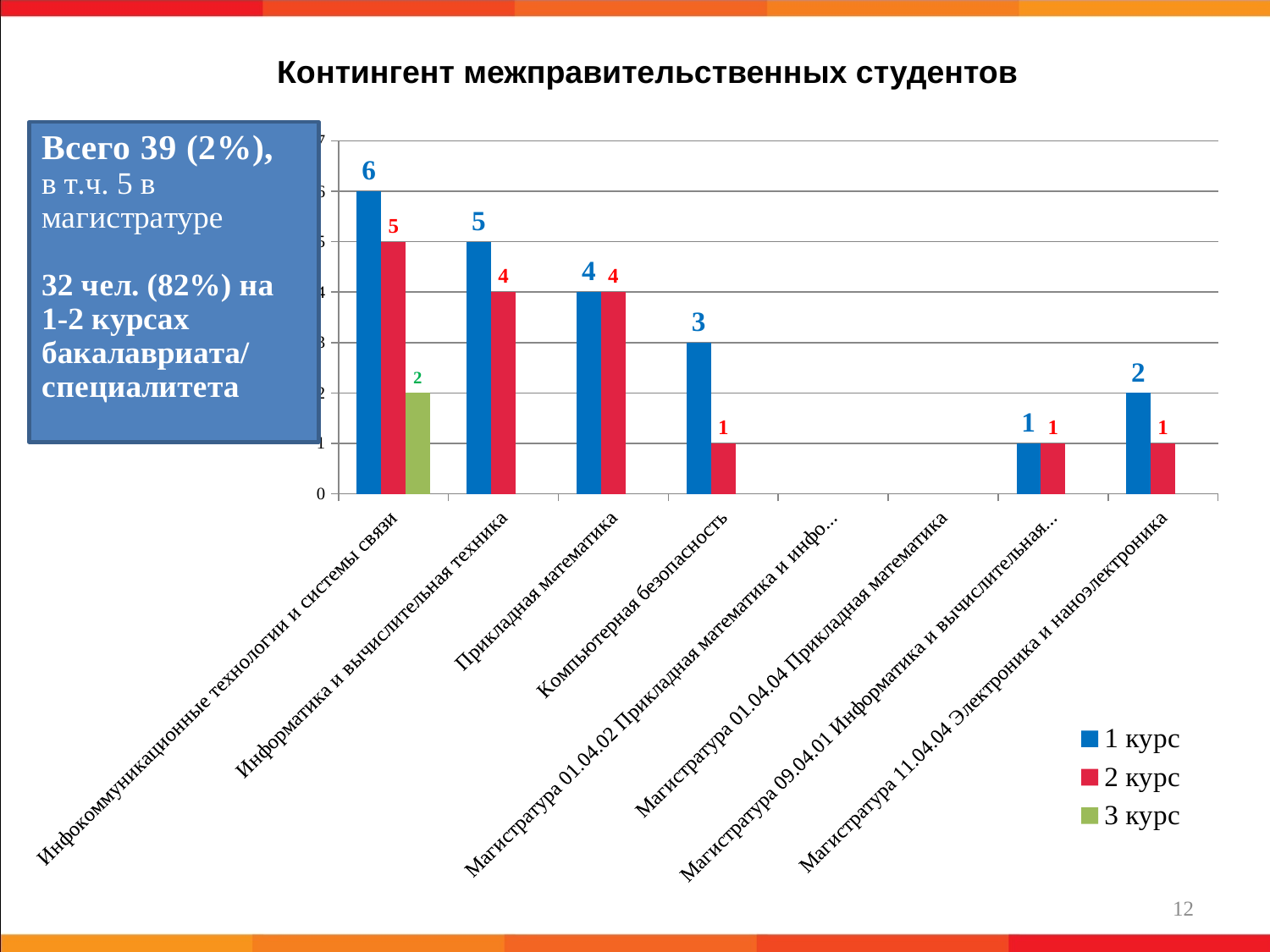
What is the value for 1 курс in the category Инфокоммуникационные технологии и системы связи? 6 What is the value for 2 курс in the category Прикладная математика? 4 What is the value for 1 курс in the category Компьютерная безопасность? 3 How many categories are shown on the x axis? 8 What is the value for 3 курс in the category Инфокоммуникационные технологии и системы связи? 2 What is the value for 2 курс in the category Информатика и вычислительная техника? 4 What is the title of the chart? Контингент межправительственных студентов Which category has the highest value for 1 курс? Инфокоммуникационные технологии и системы связи What type of chart is shown on the slide? bar chart Which is larger for Магистратура 11.04.04 Электроника и наноэлектроника: the 1 курс value or the 2 курс value? 1 курс What is the difference between the 1 курс and 2 курс values for Компьютерная безопасность? 2 How many series does the legend list? 3